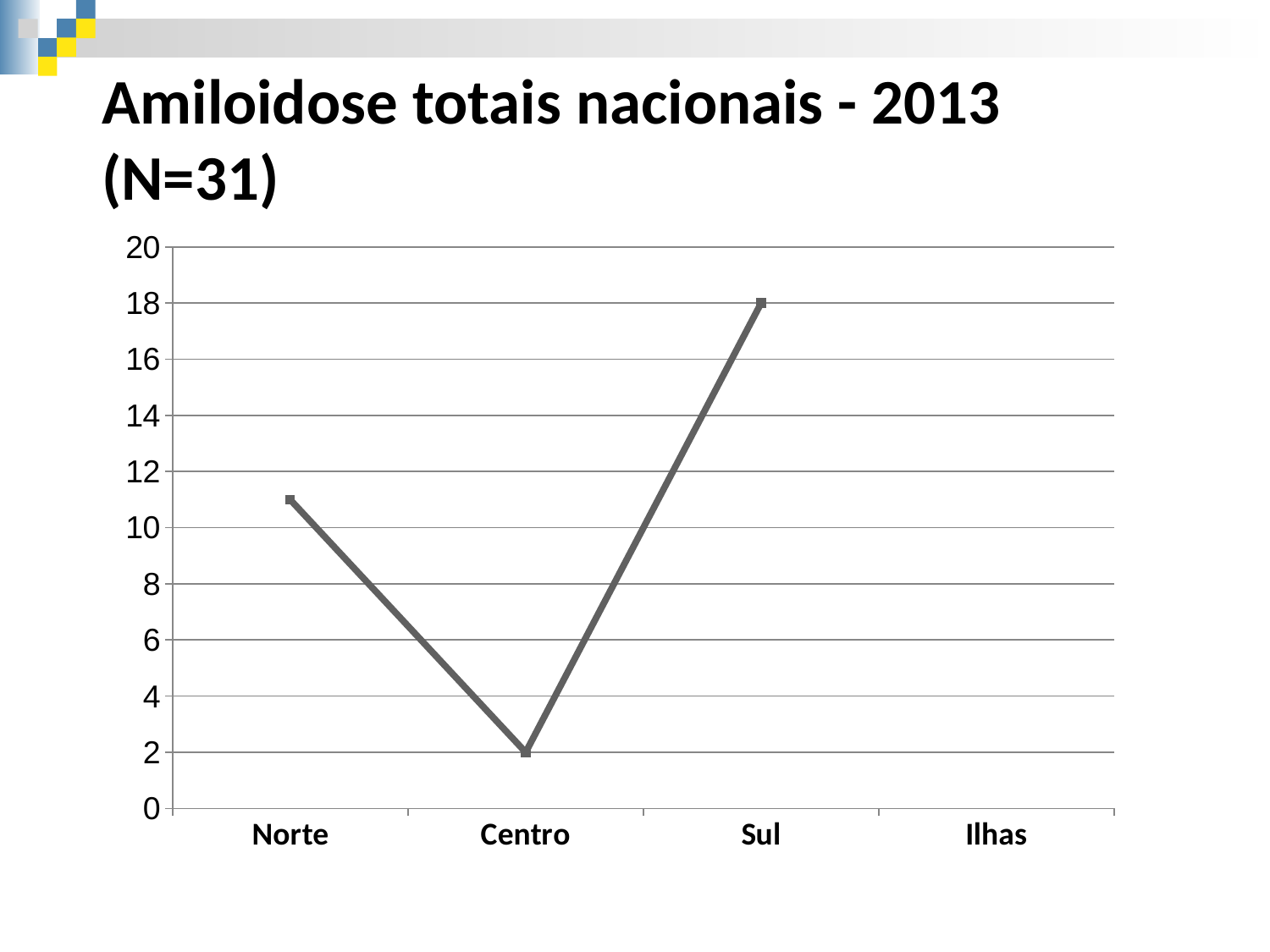
What is the difference between the values for Sul and Centro? 16 What is the value for Sul? 18 What type of chart is shown on the slide? Line chart How many categories are shown on the x axis? 4 What is the title of the slide? Amiloidose totais nacionais - 2013 (N=31) Is the value for Norte greater or less than 12? less What is the value for Centro? 2 Which of the plotted regions has the lowest value? Centro Which region has the highest value? Sul Does the line rise or fall from Centro to Sul? Rises Is the value for Norte greater or less than 10? greater Which is larger, the value for Norte or the value for Sul? Sul